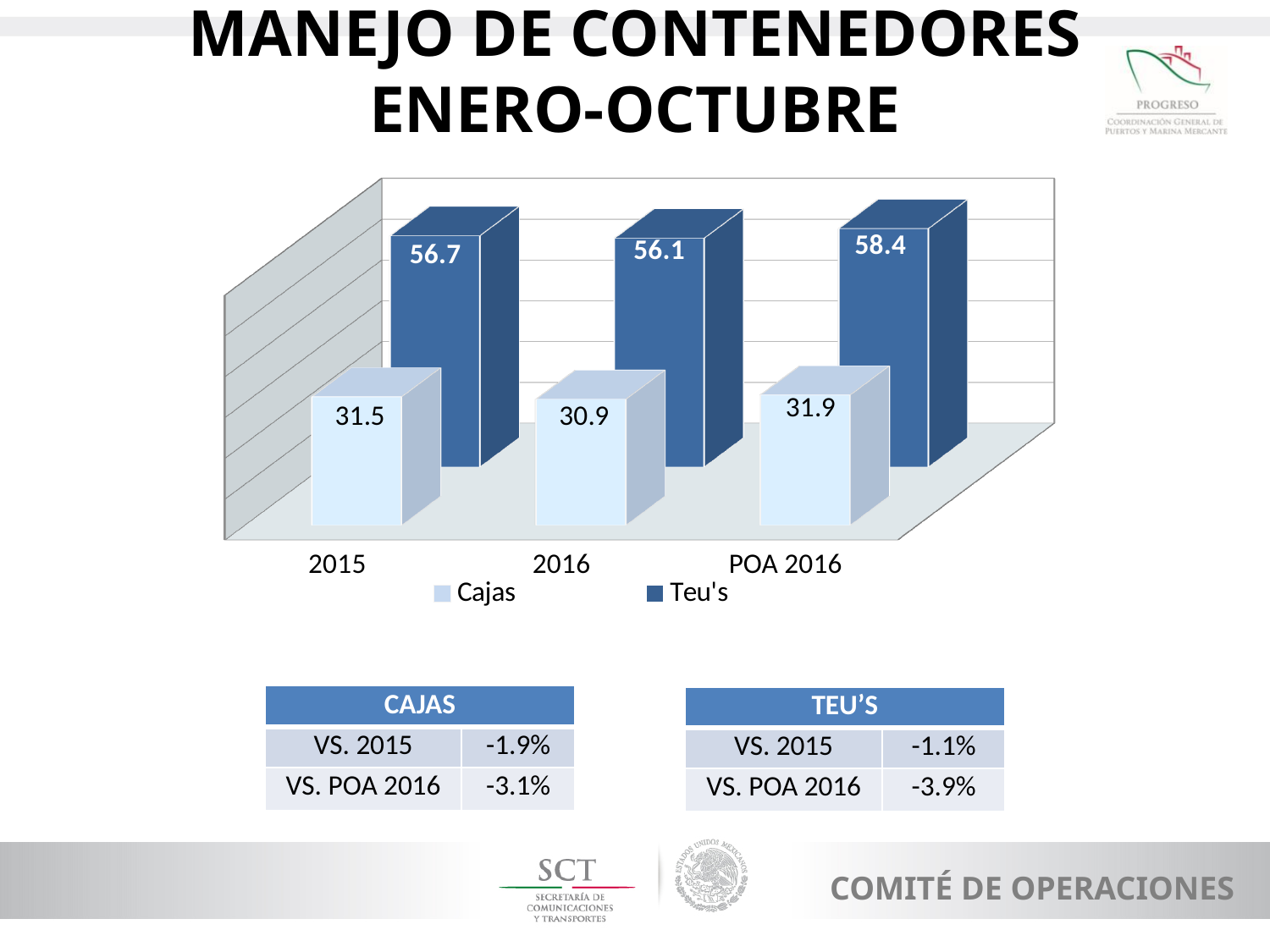
What is the value of Teu's for POA 2016? 58.4 Which category has the lowest Cajas value? 2016 Which is larger, the Teu's value for 2015 or the Teu's value for 2016? 2015 What is the difference between the Cajas value for 2015 and the Cajas value for 2016? 0.6 What is the value of Cajas for 2016? 30.9 Which category has the highest Teu's value? POA 2016 What is the difference between the Teu's value for POA 2016 and the Teu's value for 2016? 2.3 How many series does the legend list? 2 What is the value of Cajas for 2015? 31.5 What is the value of Teu's for 2015? 56.7 What kind of chart is shown on the slide? Bar chart How many categories are shown on the x axis? 3